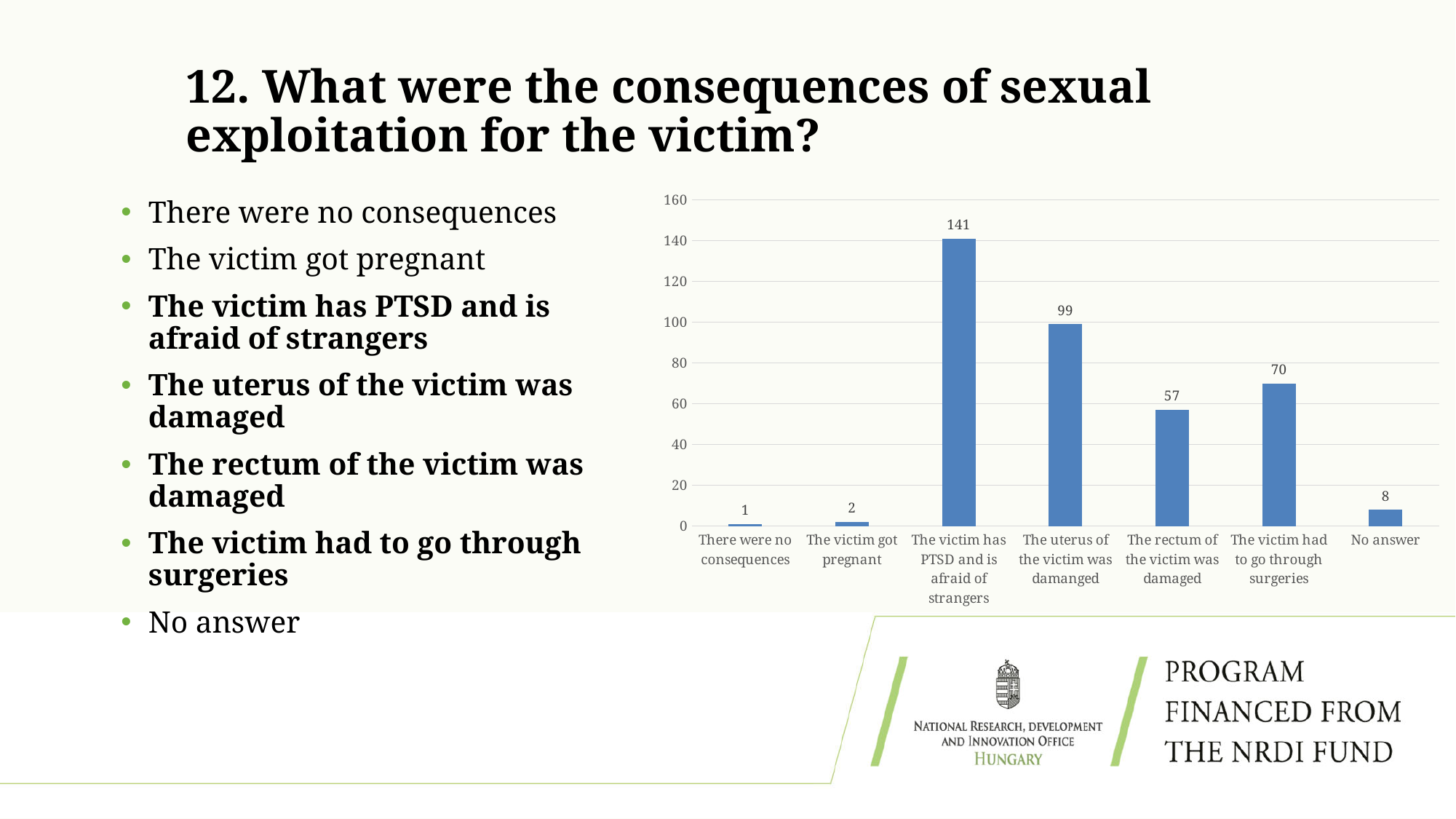
What is the value for 'The uterus of the victim was damanged'? 99 Which is larger: the value for 'The victim had to go through surgeries' or 'The rectum of the victim was damaged'? The victim had to go through surgeries What is the value for 'The victim has PTSD and is afraid of strangers'? 141 What is the value for 'The victim had to go through surgeries'? 70 What kind of chart is shown on the slide? bar chart Is the value for 'The victim has PTSD and is afraid of strangers' greater or less than 120? greater How many categories are shown on the x axis? 7 What is the value for 'No answer'? 8 Which category has the lowest value? There were no consequences What is the difference between the values for 'The uterus of the victim was damanged' and 'The rectum of the victim was damaged'? 42 Which category has the highest value? The victim has PTSD and is afraid of strangers What is the highest value shown on the y axis? 160